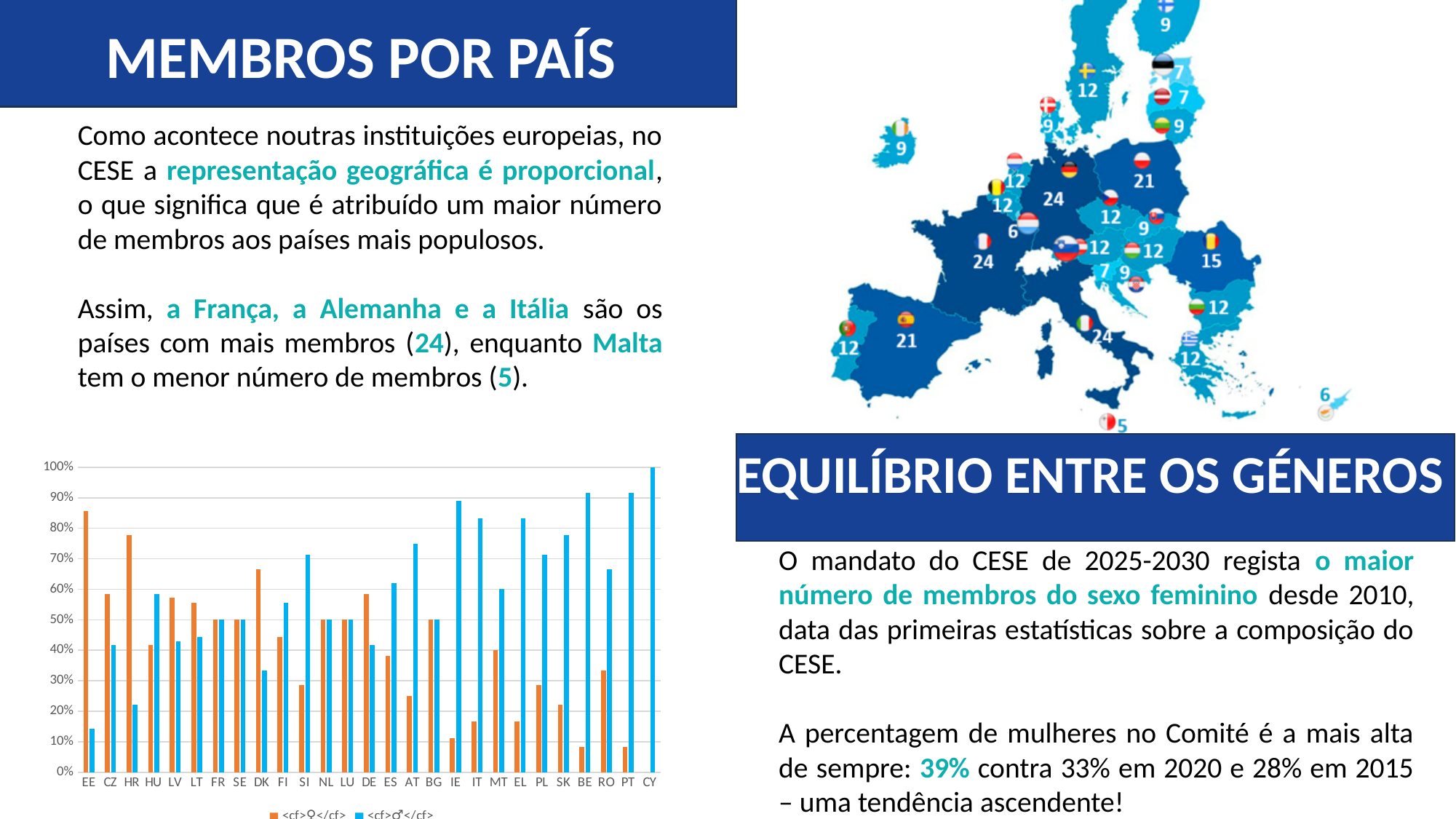
In the bar chart, is the blue bar for IE greater or less than 80%? greater In the bar chart, which country has the highest orange bar? EE In the bar chart, which is larger for EE, the orange bar or the blue bar? the orange bar In the bar chart, which country has the highest blue bar? CY In the bar chart, is the orange bar for EE greater or less than 80%? greater In the bar chart, which country has the lowest blue bar? EE How many countries are listed along the x axis of the bar chart? 27 In the bar chart, is the orange bar for HR greater or less than 70%? greater In the bar chart, what value does the blue bar for CY reach? 100% In the bar chart, which is larger for IT, the orange bar or the blue bar? the blue bar What kind of chart is shown at the bottom left of the slide? bar chart How many series does the legend of the bar chart list? 2